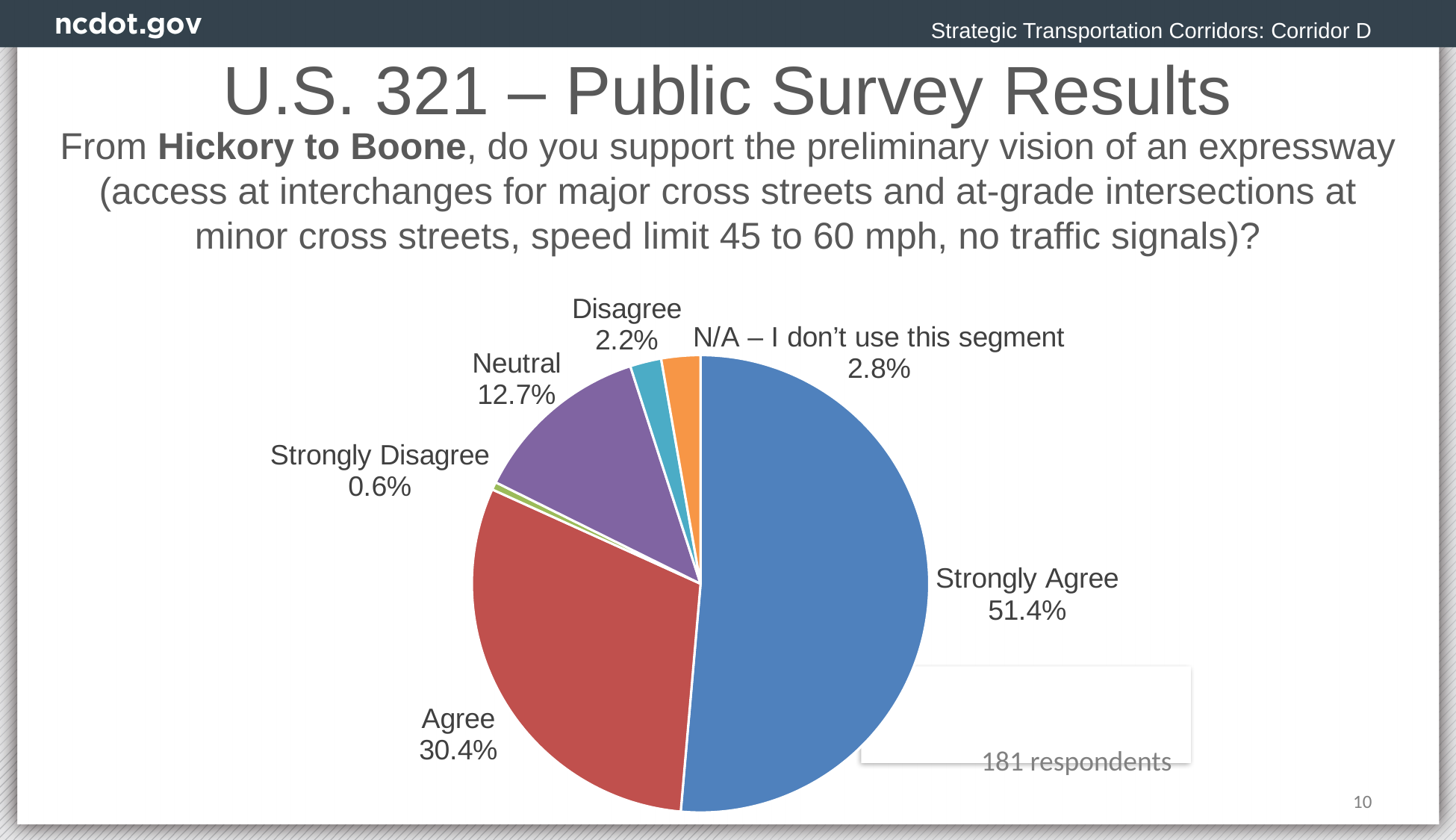
How many respondents does the chart note? 181 Which response category has the largest share of the pie? Strongly Agree What percentage of respondents answered Neutral? 12.7% What percentage of respondents answered Strongly Agree? 51.4% What percentage of respondents answered Agree? 30.4% How many response categories are shown in the pie chart? 6 What kind of chart is shown on the slide? pie chart What percentage of respondents chose 'N/A – I don't use this segment'? 2.8% Which response category has the smallest share of the pie? Strongly Disagree Which is larger, the share for Disagree or the share for N/A – I don't use this segment? N/A – I don't use this segment What percentage of respondents answered Strongly Disagree? 0.6% What is the difference in percentage points between Strongly Agree and Agree? 21.0%